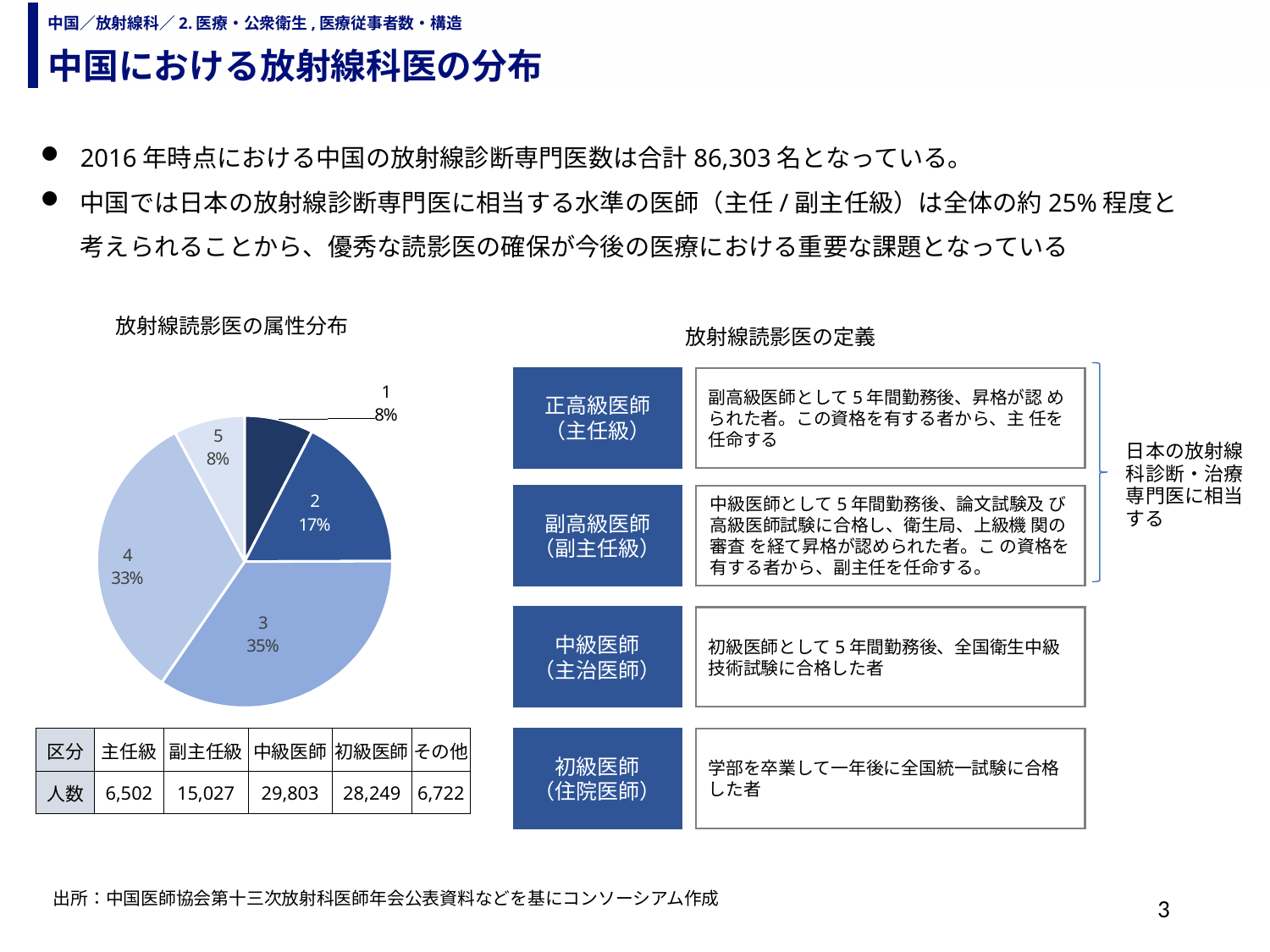
In the pie chart 放射線読影医の属性分布, which slice has the largest share? 3 What kind of chart is shown under the title 放射線読影医の属性分布? pie chart In the pie chart 放射線読影医の属性分布, what percentage is shown for slice 3? 35% In the pie chart 放射線読影医の属性分布, what is the combined share of slices 3 and 4? 68% In the pie chart 放射線読影医の属性分布, how many slices are there? 5 In the pie chart 放射線読影医の属性分布, what percentage is shown for slice 4? 33% In the pie chart 放射線読影医の属性分布, what percentage is shown for slice 2? 17% In the pie chart 放射線読影医の属性分布, which is larger, slice 2 or slice 5? slice 2 What is the title of the pie chart on the left of the slide? 放射線読影医の属性分布 In the pie chart 放射線読影医の属性分布, what percentage is shown for slice 5? 8% In the pie chart 放射線読影医の属性分布, what percentage is shown for slice 1? 8% In the pie chart 放射線読影医の属性分布, what is the difference in percentage points between slice 3 and slice 4? 2